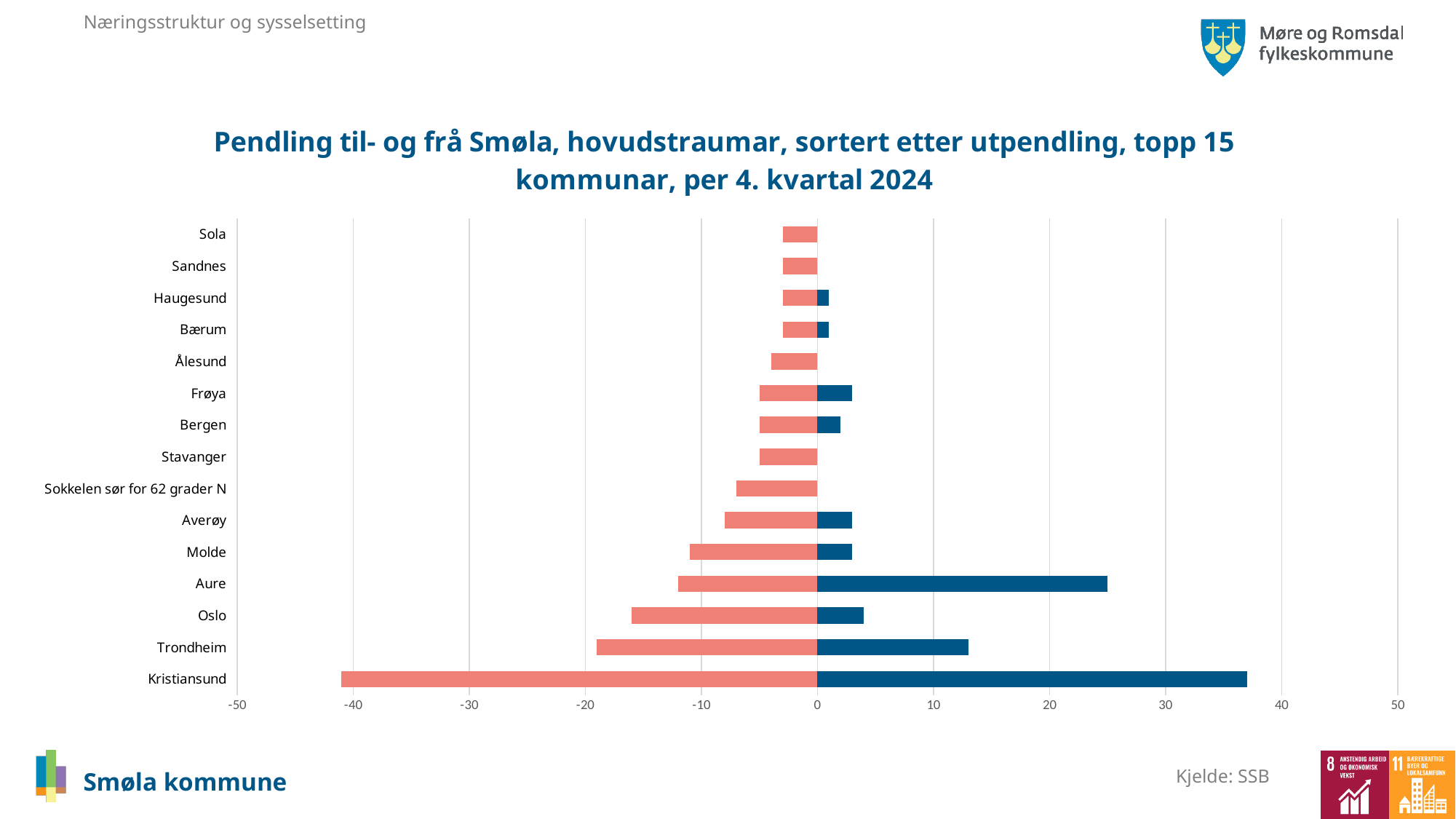
Is the red bar value for Averøy greater or less than -10? greater Which category has the longest blue (positive) bar? Kristiansund How many municipalities/categories are listed on the vertical axis of the chart? 15 Which has the longer red bar, Oslo or Trondheim? Trondheim Which category is listed at the top of the chart? Sola Is the blue bar value for Kristiansund greater or less than 30? greater Is the red bar value for Oslo greater or less than -10? less Which category has the longest red (negative) bar? Kristiansund What kind of chart is shown on the slide? bar chart Which has the larger blue bar, Aure or Trondheim? Aure